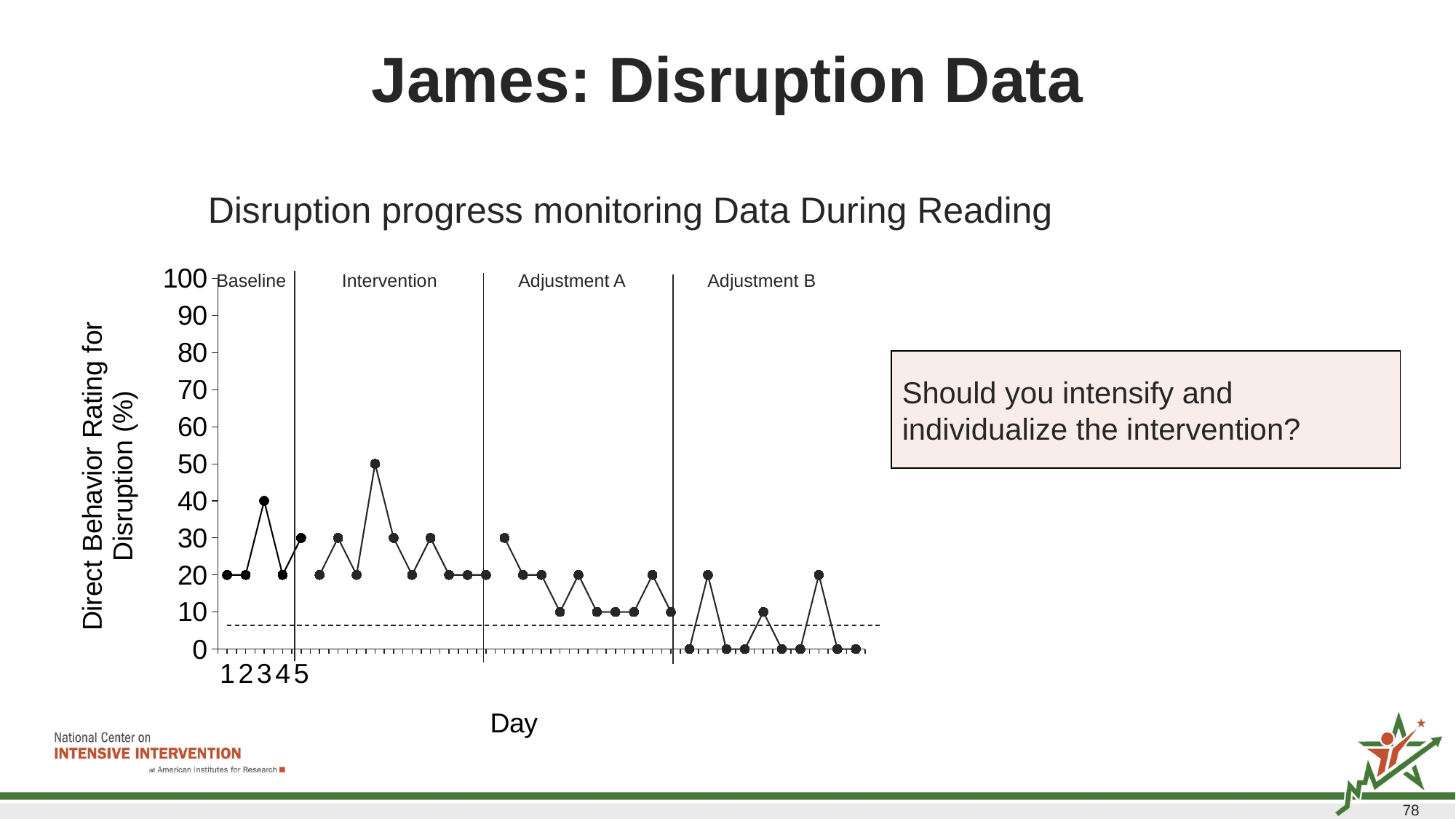
What is the title of the y-axis? Direct Behavior Rating for Disruption (%) Is the value for Day 3 greater or less than 30? greater What kind of chart is shown on the slide? line chart What is the Direct Behavior Rating for Disruption on Day 5? 30 In which phase does the highest plotted value (50) occur? Intervention What is the difference between the Day 3 value and the Day 1 value? 20 How many phases are labeled on the chart? 4 Which day has the higher value, Day 3 or Day 5? Day 3 What is the Direct Behavior Rating for Disruption on Day 3? 40 What is the Direct Behavior Rating for Disruption on Day 1? 20 What is the highest Direct Behavior Rating value plotted on the chart? 50 What is the lowest Direct Behavior Rating value plotted on the chart? 0